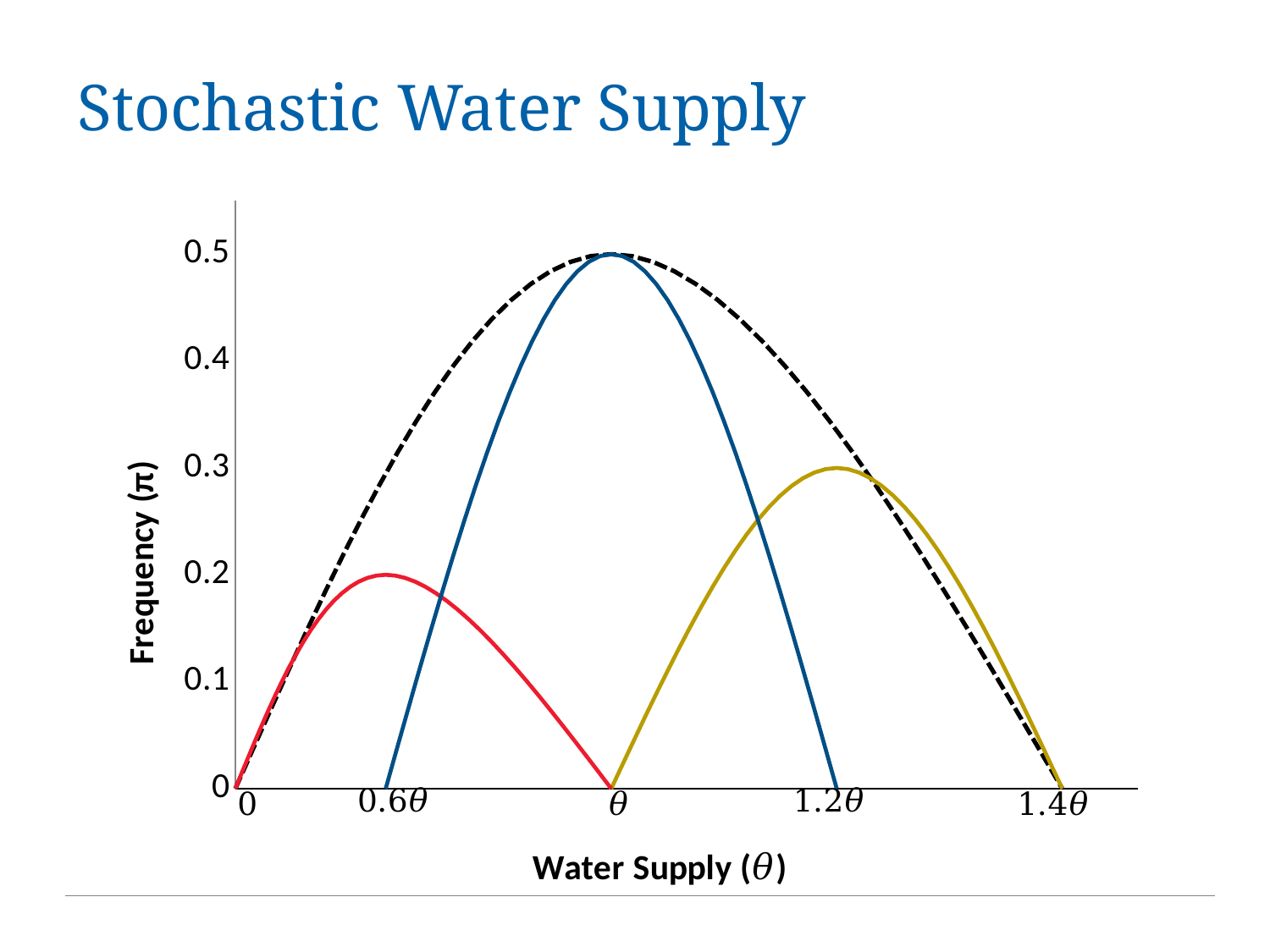
How many curves are plotted on the chart? 4 What is the peak frequency of the blue curve? 0.5 What kind of chart is shown on the slide? line chart At what water supply value does the blue curve reach its peak? θ At what water supply value does the yellow curve reach its peak? 1.2θ Is the peak of the yellow curve greater or less than 0.2? greater Which has a higher peak, the yellow curve or the red curve? the yellow curve What is the label of the x axis? Water Supply (θ) Does the blue curve rise or fall between 0.6θ and θ? rise Which solid curve has the lowest peak frequency? the red curve Is the peak of the red curve greater or less than 0.3? less Which curve reaches the highest peak frequency? the blue curve and the black dashed curve (both peak at 0.5)